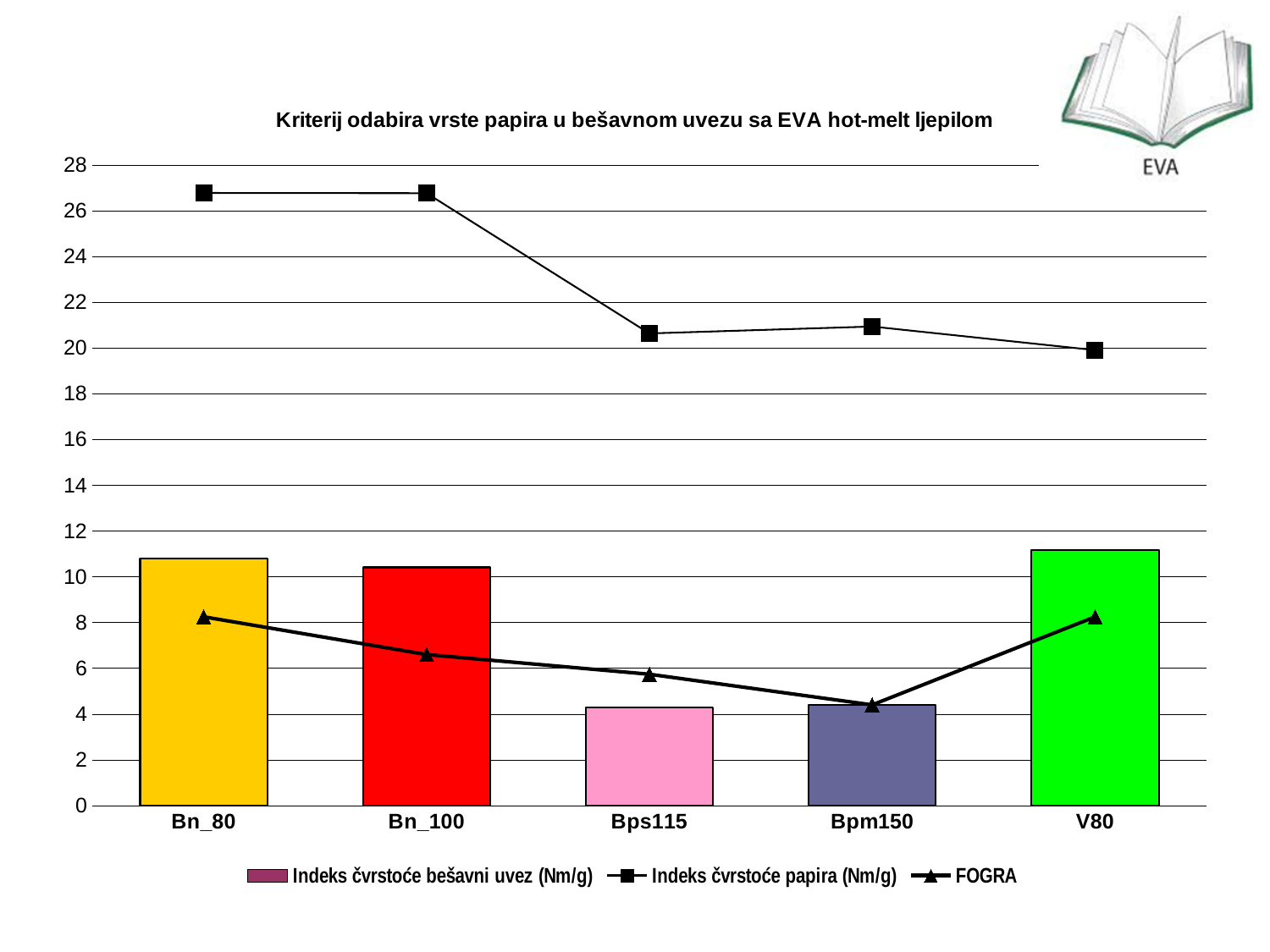
Which category has the tallest bar for Indeks čvrstoće bešavni uvez (Nm/g)? V80 How many paper types (categories) are shown on the x axis? 5 How many series does the legend list? 3 Is the Indeks čvrstoće bešavni uvez bar for Bps115 greater or less than 6? less Which category has the lowest FOGRA value? Bpm150 Which series in the legend is drawn with triangle markers? FOGRA Which has the larger Indeks čvrstoće papira value, Bn_100 or Bps115? Bn_100 Is the Indeks čvrstoće bešavni uvez bar for Bn_80 greater or less than 10? greater Is the Indeks čvrstoće papira value for Bn_80 greater or less than 26? greater Which category has the lowest value on the Indeks čvrstoće papira (Nm/g) line? V80 What kind of chart is shown on the slide? A combined bar and line chart